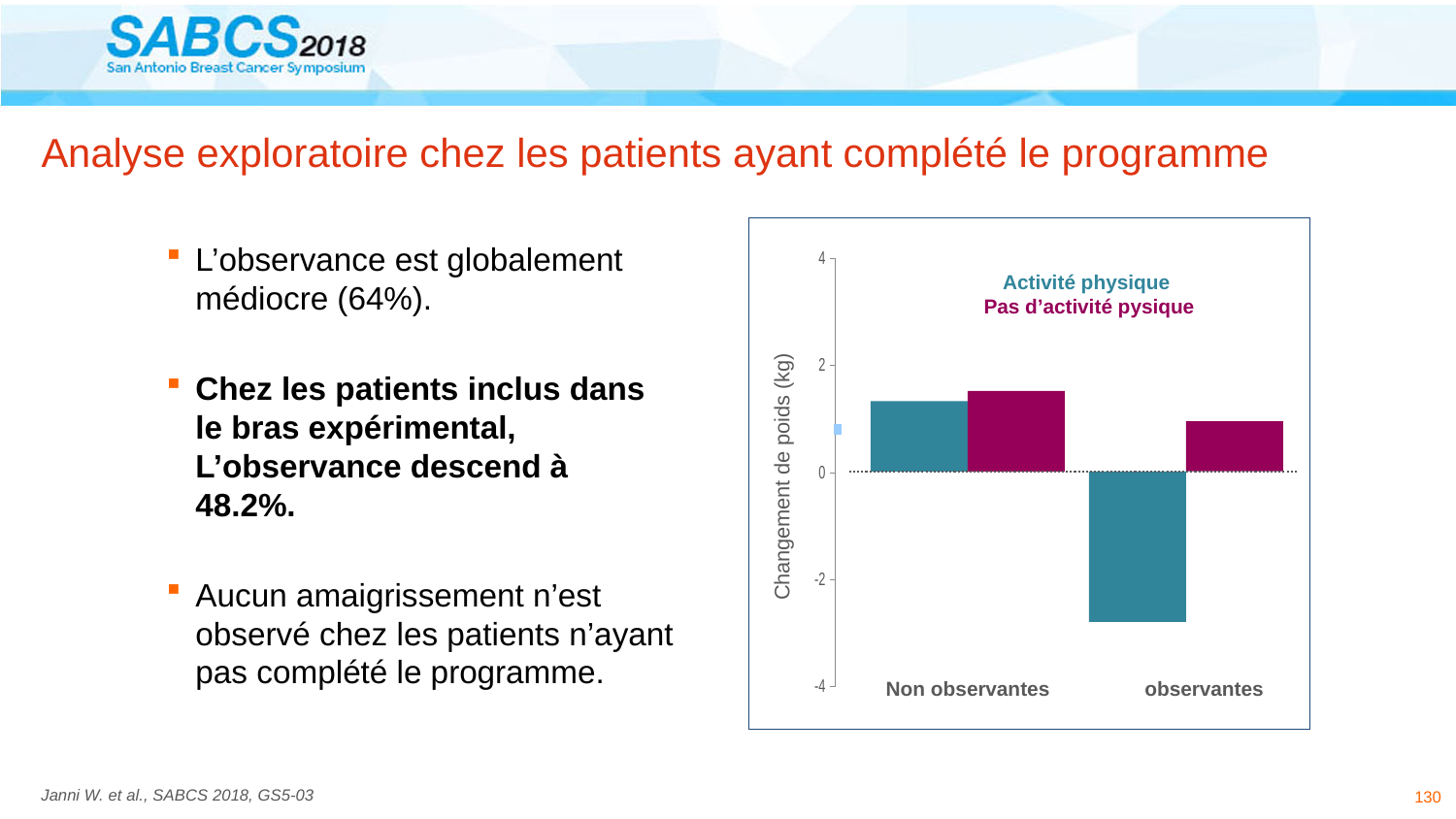
Is the value for Pas d'activité pysique among observantes greater or less than 0? greater Is the value for Activité physique among Non observantes greater or less than 0? greater How many categories are shown on the x axis of the chart? 2 Which series is shown in magenta in the chart? Pas d'activité pysique What kind of chart is shown on the slide? bar chart How many series does the chart's legend list? 2 Which bar in the chart has the lowest value? observantes, Activité physique Among observantes, which series has the larger value: Activité physique or Pas d'activité pysique? Pas d'activité pysique Is the value for Activité physique among observantes greater or less than 0? less What is the label of the y axis of the chart? Changement de poids (kg)